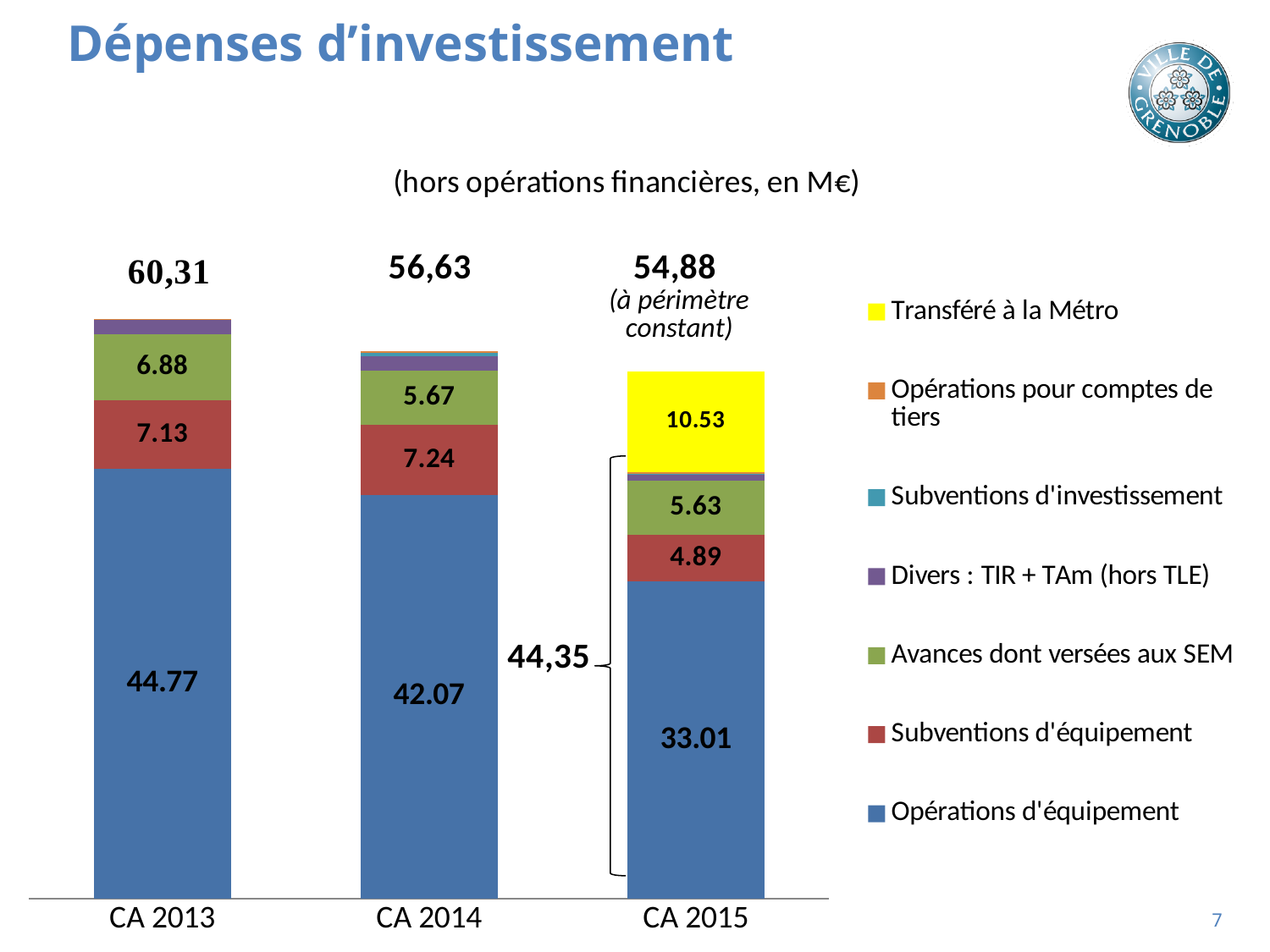
What is the value of Avances dont versées aux SEM for CA 2015? 5.63 How many series does the legend list? 7 Is Subventions d'équipement larger in CA 2013 or CA 2014? CA 2014 What kind of chart is shown on the slide? Stacked bar chart Which year has the highest value for Opérations d'équipement? CA 2013 What is the value of Opérations d'équipement for CA 2013? 44.77 What is the value of Transféré à la Métro for CA 2015? 10.53 What is the value of Subventions d'équipement for CA 2014? 7.24 What is the total shown above the CA 2014 bar? 56,63 What is the difference between Opérations d'équipement in CA 2013 and CA 2014? 2.70 What is the total shown above the CA 2013 bar? 60,31 Which year has the lowest value for Subventions d'équipement? CA 2015